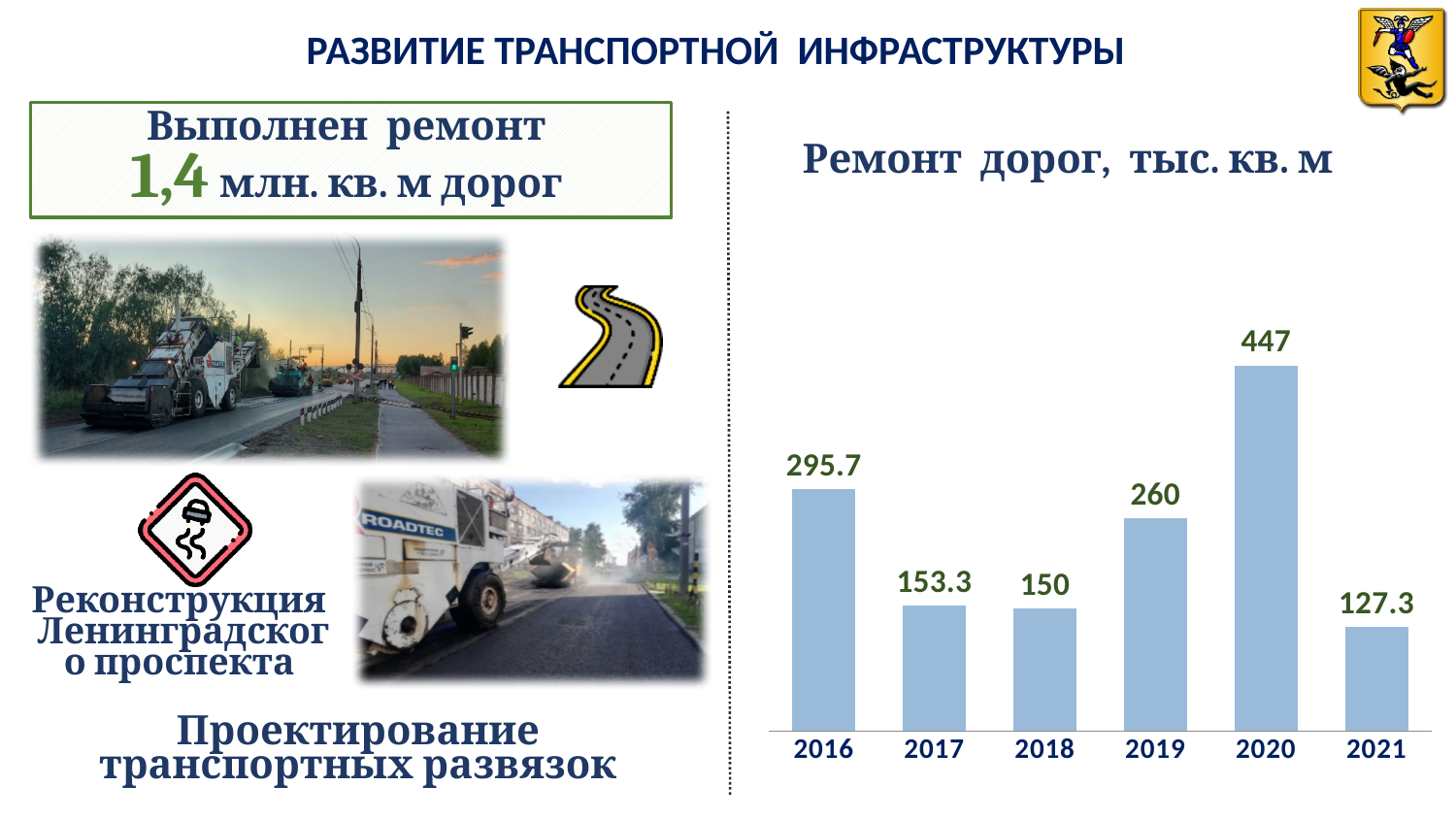
How many years are shown in the road repair chart? 6 Which year has the highest value in the road repair chart? 2020 What is the value for 2016 in the road repair chart? 295.7 What is the difference between the values for 2020 and 2019 in the road repair chart? 187 What is the title of the chart on the slide? Ремонт дорог, тыс. кв. м What is the value for 2021 in the road repair chart? 127.3 What is the value for 2020 in the road repair chart? 447 What is the value for 2018 in the road repair chart? 150 What kind of chart is used to show road repair by year? bar chart What is the difference between the values for 2017 and 2018 in the road repair chart? 3.3 Which year has the lowest value in the road repair chart? 2021 Which is larger in the road repair chart, the value for 2016 or the value for 2019? 2016